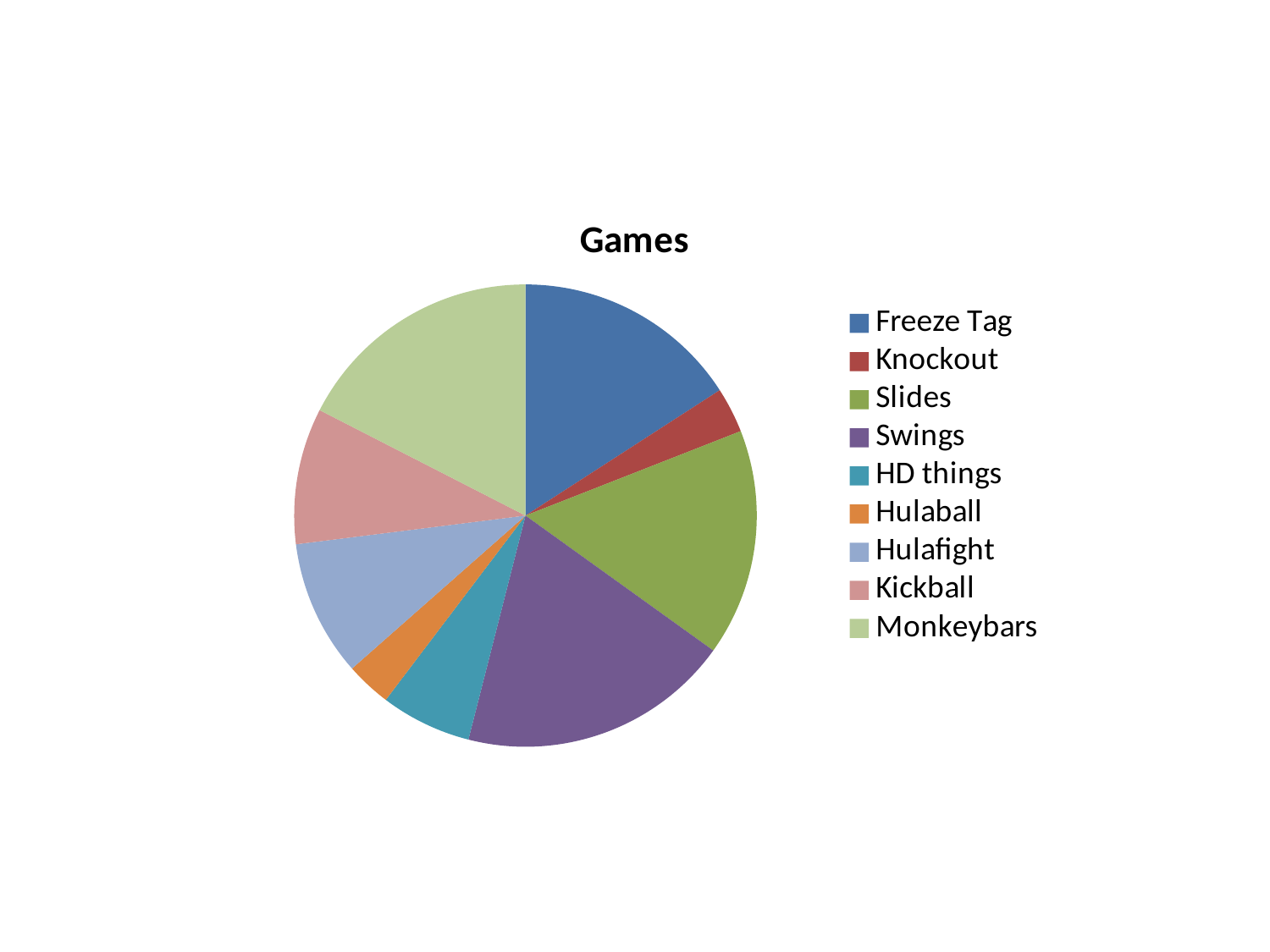
Which slice is larger, Freeze Tag or Knockout? Freeze Tag How many entries does the legend list? 9 What kind of chart is shown on the slide? pie chart Which slice is larger, Monkeybars or Hulafight? Monkeybars What is the title of the chart? Games Which slice is larger, Kickball or Knockout? Kickball How many categories (slices) does the pie chart have? 9 What colour is the Freeze Tag slice? blue